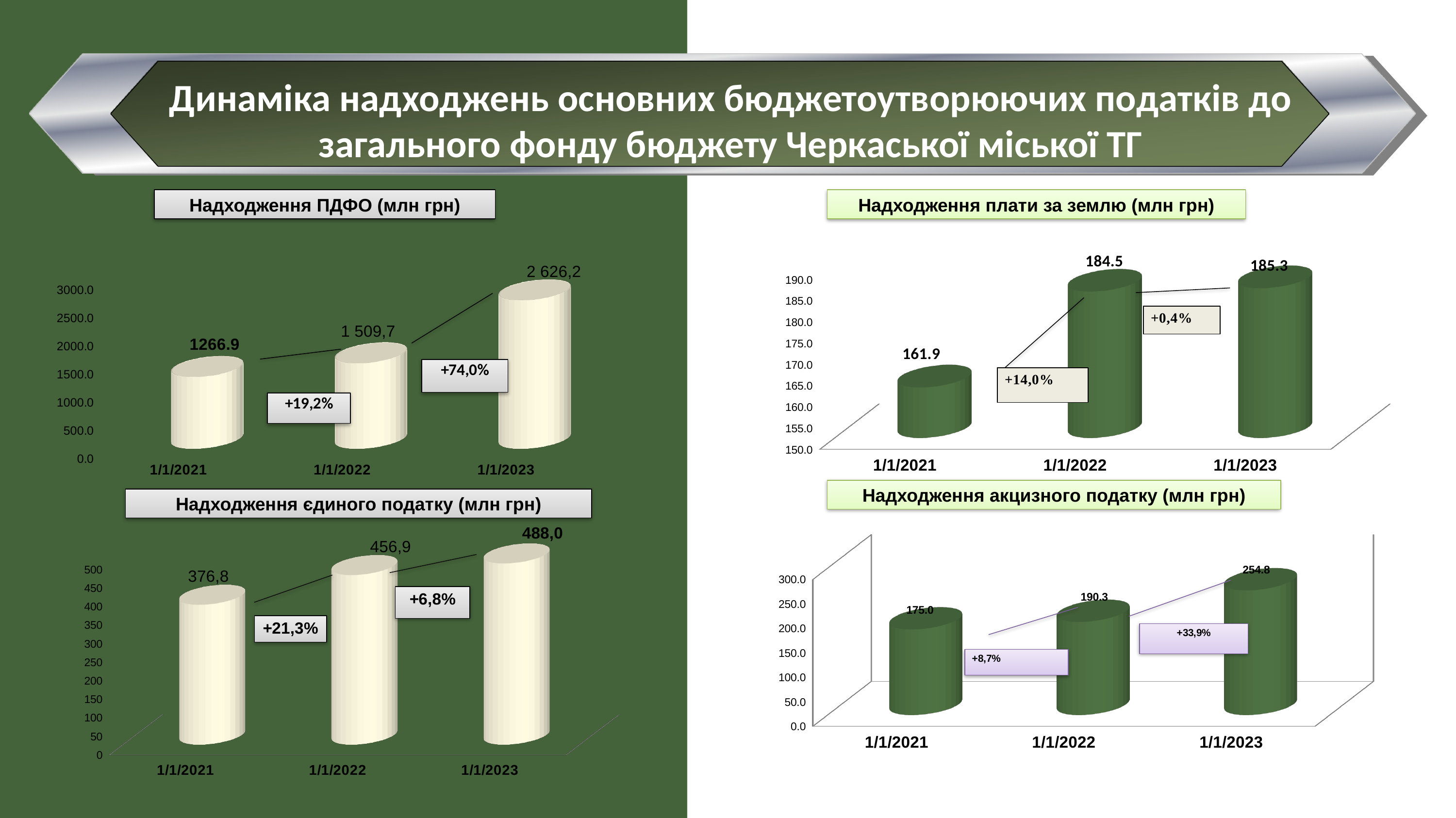
In the chart titled 'Надходження ПДФО (млн грн)', what is the value for 1/1/2021? 1266.9 In the chart titled 'Надходження акцизного податку (млн грн)', what is the value for 1/1/2023? 254.8 In the chart titled 'Надходження єдиного податку (млн грн)', what is the value for 1/1/2022? 456,9 In the chart titled 'Надходження ПДФО (млн грн)', what is the value for 1/1/2023? 2 626,2 What kind of chart is the one titled 'Надходження єдиного податку (млн грн)'? bar chart In the chart titled 'Надходження акцизного податку (млн грн)', do the values rise or fall from 1/1/2021 to 1/1/2023? rise In the chart titled 'Надходження ПДФО (млн грн)', what percentage change is shown between 1/1/2022 and 1/1/2023? +74,0% In the chart titled 'Надходження плати за землю (млн грн)', what is the difference between the values for 1/1/2022 and 1/1/2021? 22.6 How many dates are shown on the x axis of the chart titled 'Надходження ПДФО (млн грн)'? 3 In the chart titled 'Надходження акцизного податку (млн грн)', which date has the highest value? 1/1/2023 In the chart titled 'Надходження плати за землю (млн грн)', which date has the lowest value? 1/1/2021 In the chart titled 'Надходження єдиного податку (млн грн)', what is the difference between the values for 1/1/2023 and 1/1/2021? 111,2